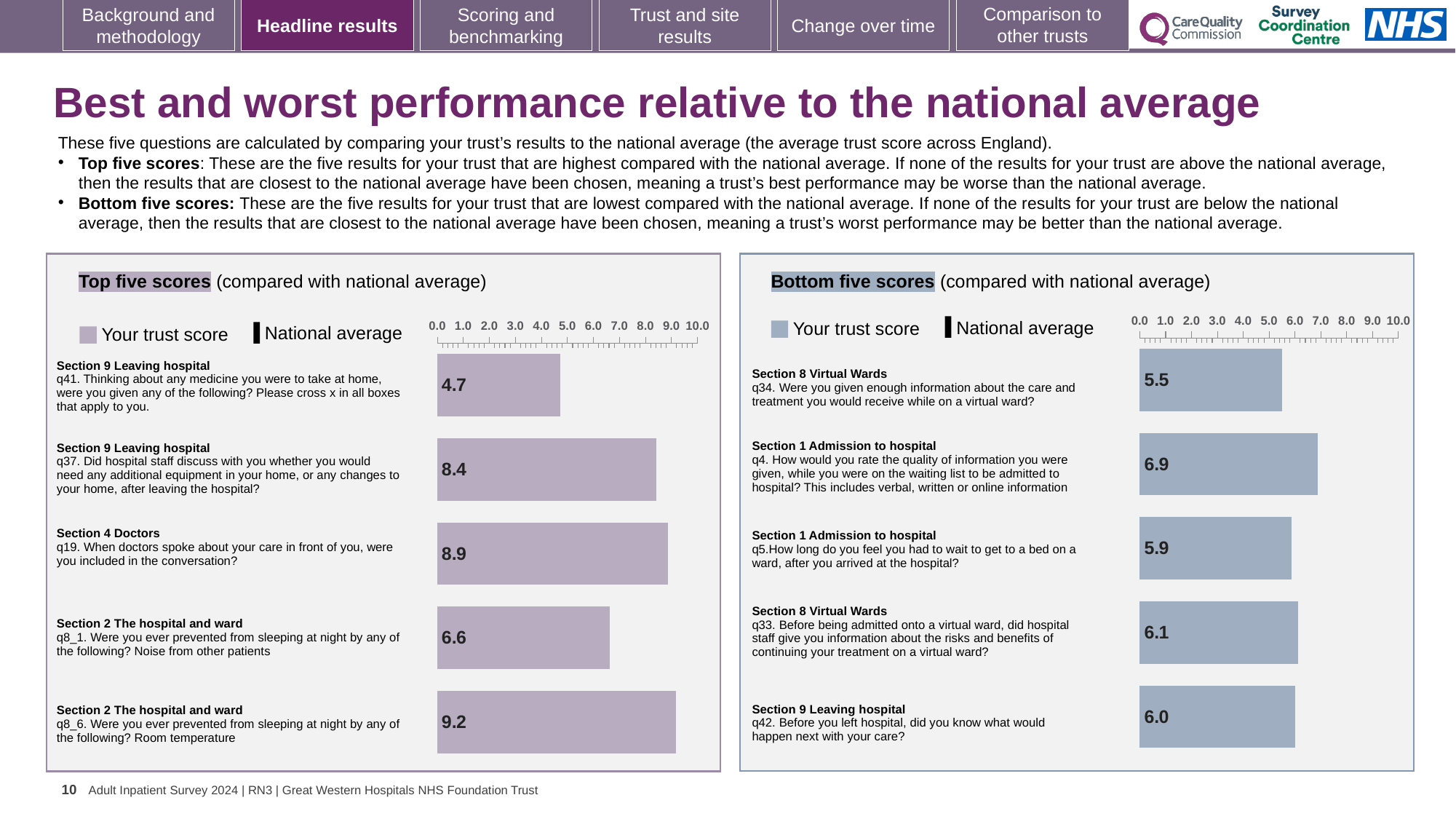
How many questions are plotted in the Top five scores chart? 5 What type of chart is used in the Bottom five scores panel? Bar chart In the Top five scores chart, which question has the highest trust score? q8_6. Room temperature (9.2) How many entries does the legend of the Top five scores chart list? 2 In the Bottom five scores chart, which question has the highest trust score? q4. Quality of information while on the waiting list (6.9) In the Bottom five scores chart, what is the trust score for q4 (How would you rate the quality of information you were given while on the waiting list)? 6.9 In the Top five scores chart, what is the difference between the score for q8_6 (Room temperature) and the score for q41 (Medicine to take at home)? 4.5 In the Top five scores chart, what is the trust score for q19 (When doctors spoke about your care in front of you, were you included in the conversation?)? 8.9 In the Bottom five scores chart, which question has the lowest trust score? q34. Information about care on a virtual ward (5.5) In the Top five scores chart, which has the larger score: q37 (additional equipment in your home) or q8_1 (Noise from other patients)? q37 (8.4) In the Top five scores chart, which question has the lowest trust score? q41. Medicine to take at home (4.7) In the Bottom five scores chart, what is the difference between the score for q4 and the score for q34? 1.4